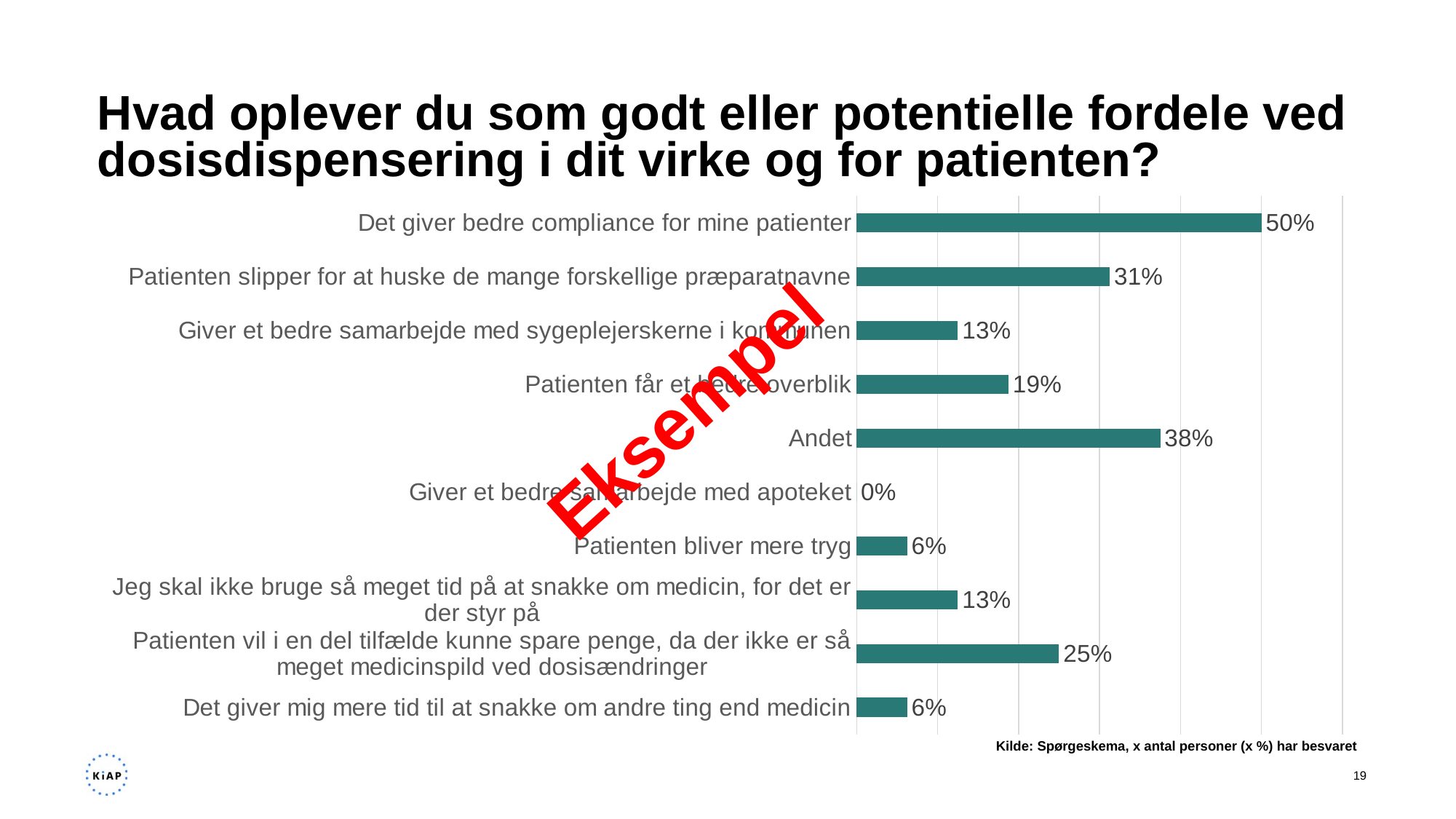
Which category has the highest value? Det giver bedre compliance for mine patienter Which is larger: the value for "Andet" or the value for "Patienten slipper for at huske de mange forskellige præparatnavne"? Andet What is the difference between the values for "Patienten vil i en del tilfælde kunne spare penge, da der ikke er så meget medicinspild ved dosisændringer" and "Det giver mig mere tid til at snakke om andre ting end medicin"? 19% What is the value for "Patienten slipper for at huske de mange forskellige præparatnavne"? 31% What is the value for "Andet"? 38% What kind of chart is shown on the slide? Bar chart How many categories are shown in the chart? 10 What is the value for "Patienten vil i en del tilfælde kunne spare penge, da der ikke er så meget medicinspild ved dosisændringer"? 25% What is the value for "Patienten bliver mere tryg"? 6% What colour are the bars in the chart? Teal What is the difference between the values for "Det giver bedre compliance for mine patienter" and "Andet"? 12% What is the value for "Det giver bedre compliance for mine patienter"? 50%